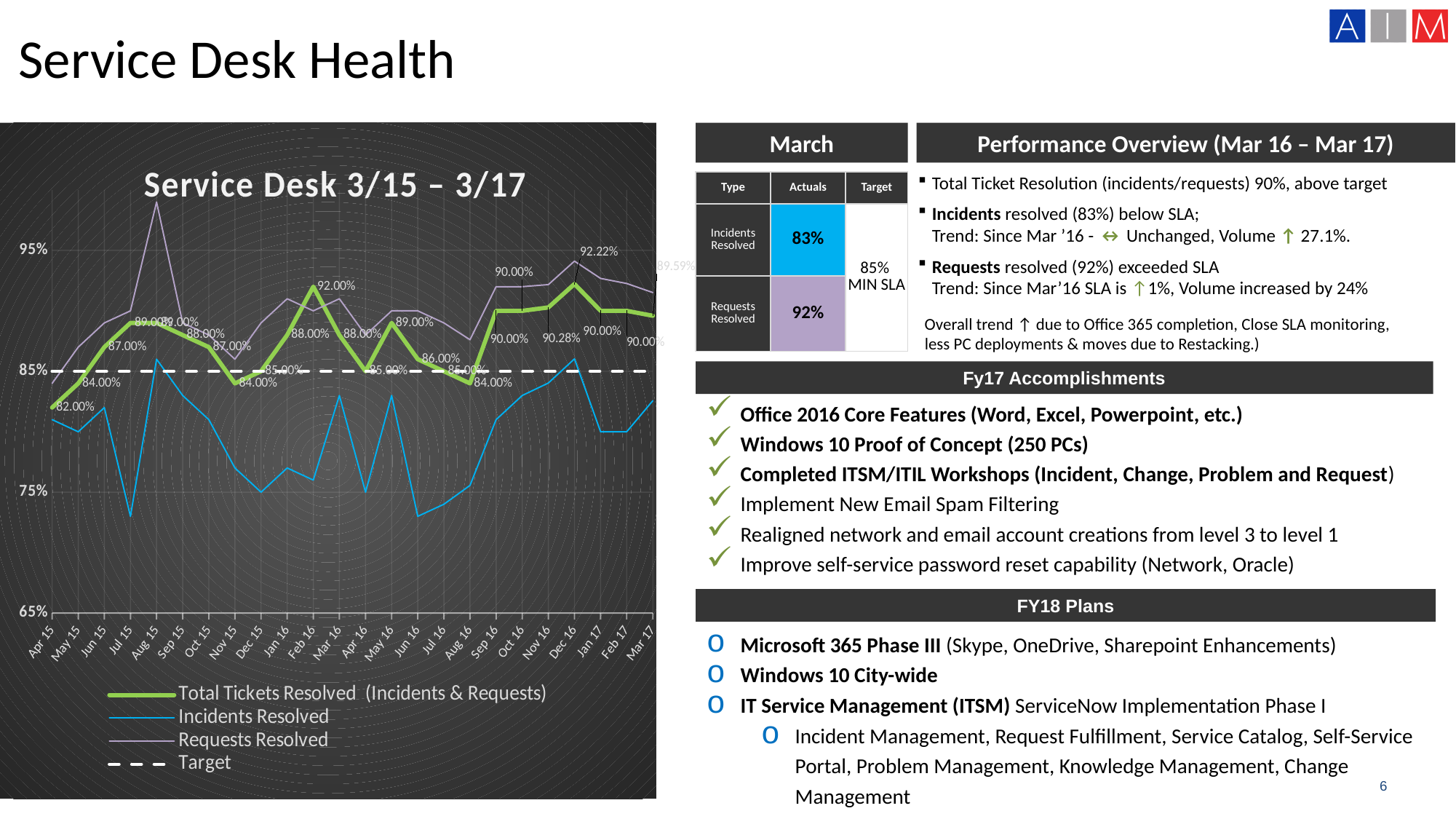
Is the Requests Resolved value for Aug 15 greater or less than 95%? greater What is the difference between Total Tickets Resolved in Feb 16 (92.00%) and Apr 15 (82.00%)? 10 percentage points What is the title of the chart on the slide? Service Desk 3/15 – 3/17 How many series does the chart legend list? 4 What is the Total Tickets Resolved value for Jun 15? 87.00% In Aug 15, which is higher: Requests Resolved or Incidents Resolved? Requests Resolved What kind of chart is shown on the slide? line chart Is the Incidents Resolved value for Jul 15 greater or less than 75%? less What is the Total Tickets Resolved value for Feb 16? 92.00% How many months are shown along the x axis of the chart? 24 In which month is Total Tickets Resolved at its lowest? Apr 15 What is the Total Tickets Resolved value for Apr 15? 82.00%